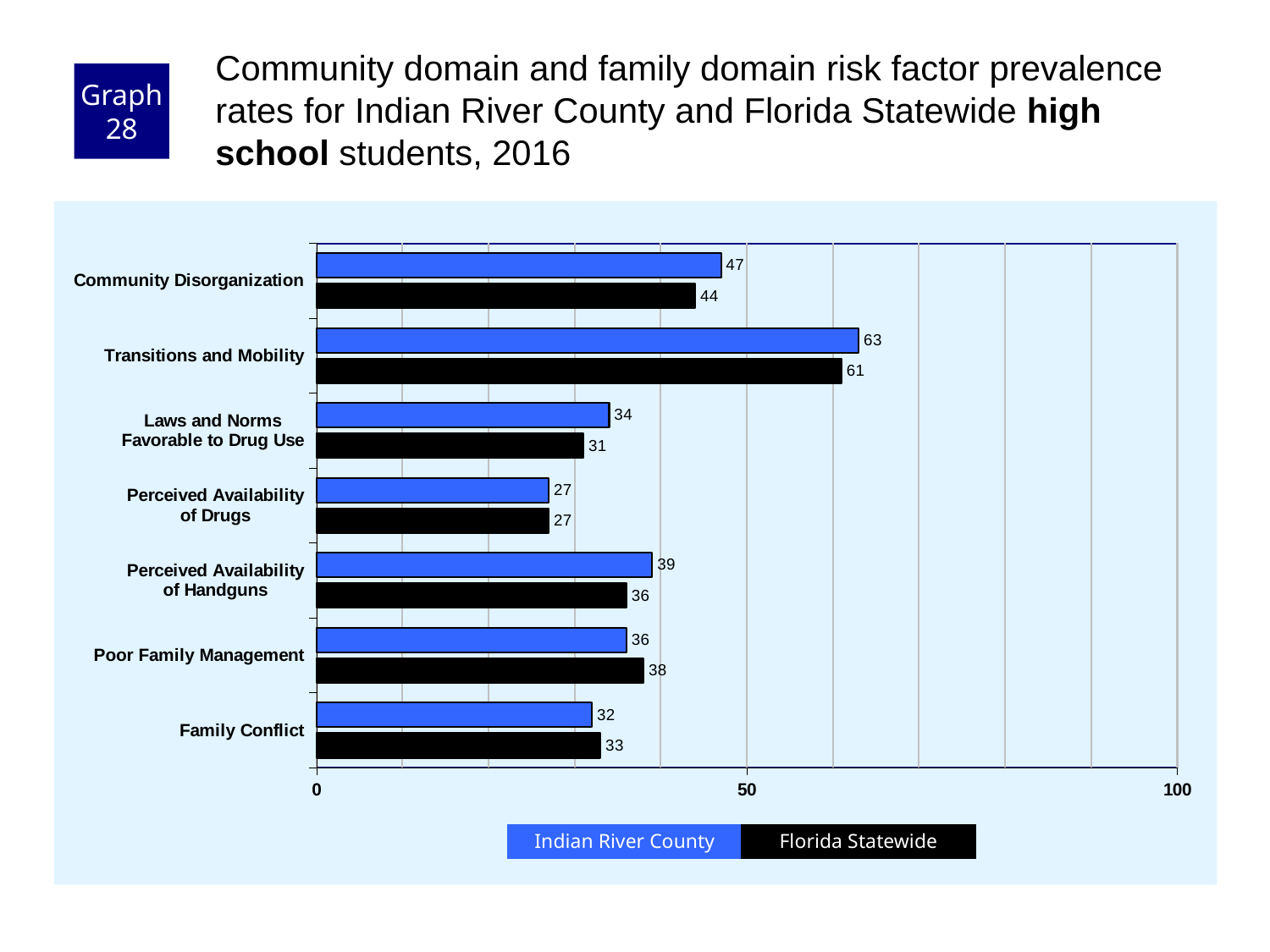
What kind of chart is shown on the slide? bar chart Which series is shown in black? Florida Statewide Is the Indian River County value for Community Disorganization greater or less than 50? less What is the difference between the Indian River County and Florida Statewide values for Laws and Norms Favorable to Drug Use? 3 What is the Florida Statewide value for Community Disorganization? 44 Which risk factor has the lowest Florida Statewide value? Perceived Availability of Drugs How many risk factors are shown on the chart? 7 Which risk factor has the highest Indian River County value? Transitions and Mobility What is the Indian River County value for Transitions and Mobility? 63 How many series does the legend list? 2 What is the Florida Statewide value for Poor Family Management? 38 For Poor Family Management, which is larger: the Indian River County value or the Florida Statewide value? Florida Statewide